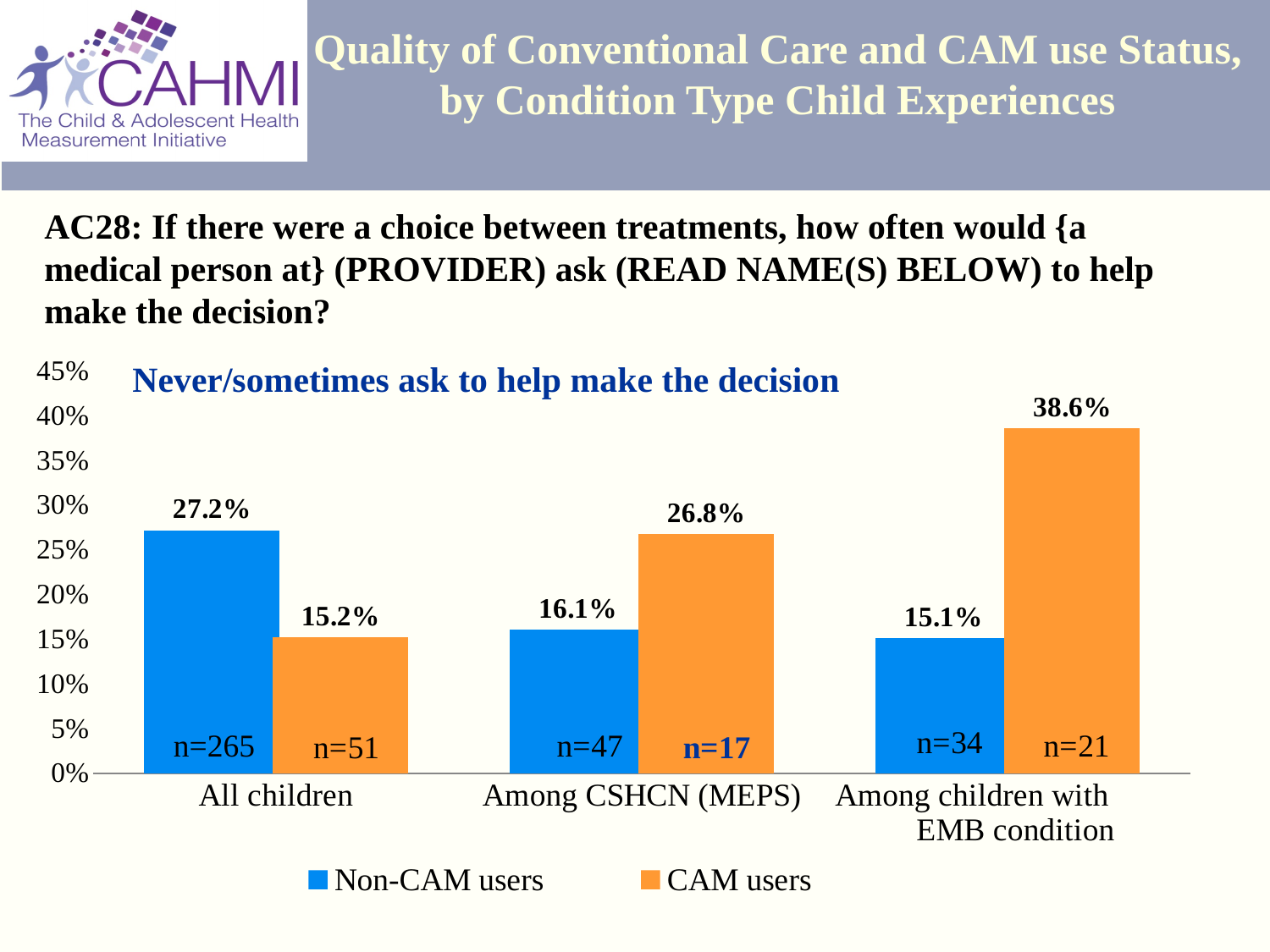
What is the difference between CAM users and Non-CAM users among children with EMB condition? 23.5% How many categories are shown on the x axis? 3 Is the value for CAM users among children with EMB condition greater or less than 35%? greater What is the value for CAM users among children with EMB condition? 38.6% Which category has the highest value for CAM users? Among children with EMB condition What is the value for CAM users among CSHCN (MEPS)? 26.8% How many series does the legend list? 2 What kind of chart is shown? Bar chart What is the sample size (n) for CAM users among CSHCN (MEPS)? n=17 Which is larger among All children: Non-CAM users or CAM users? Non-CAM users Which category has the lowest value for Non-CAM users? Among children with EMB condition What is the value for Non-CAM users among All children? 27.2%